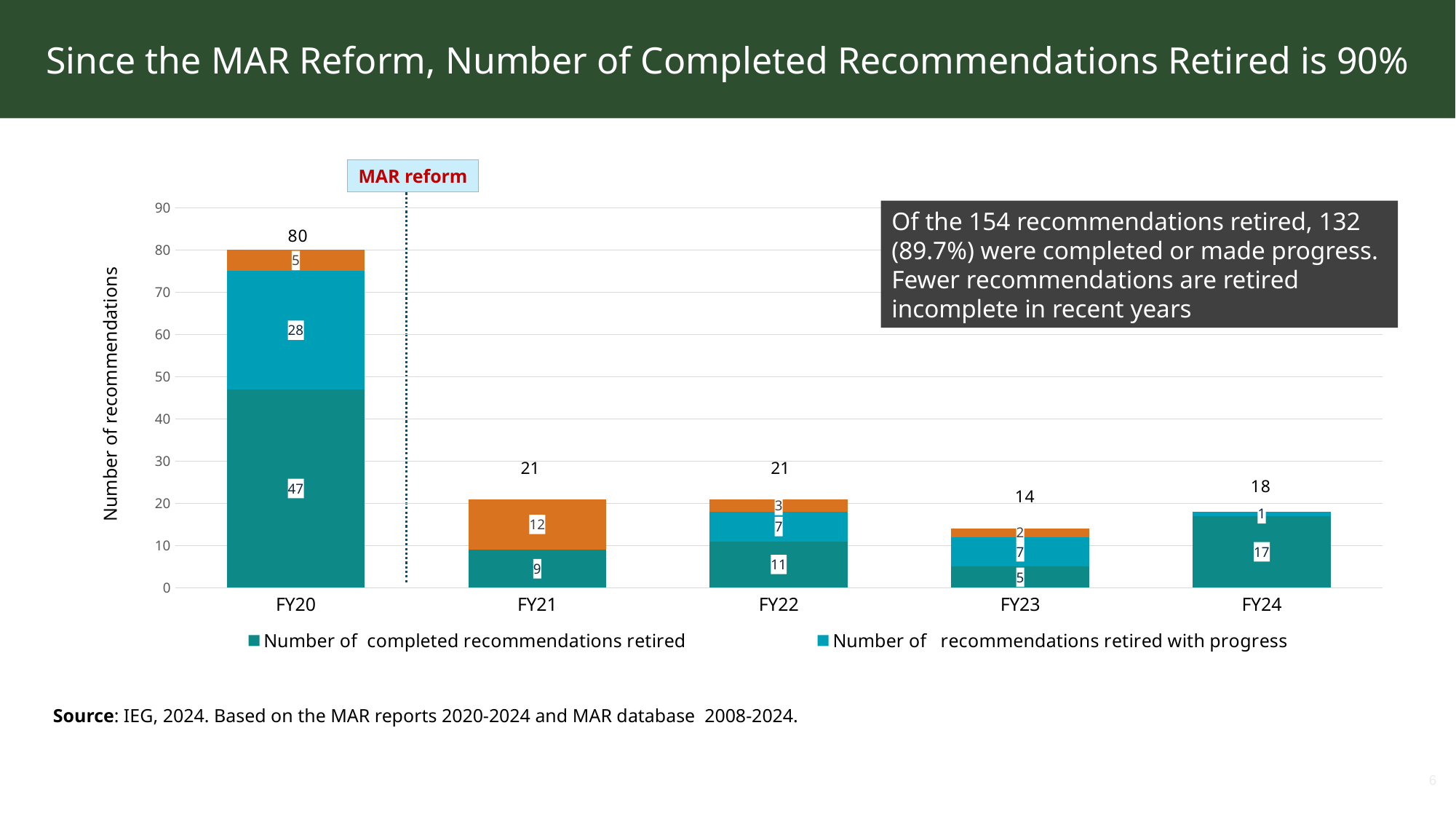
What is the number of completed recommendations retired in FY20? 47 What is the total number of recommendations retired in FY20? 80 How many fiscal years are shown on the x axis? 5 Which fiscal year has the highest total number of recommendations retired? FY20 Which year has more completed recommendations retired, FY22 or FY23? FY22 Which fiscal year has the lowest total number of recommendations retired? FY23 What kind of chart is shown on the slide? Stacked bar chart How many series does the legend list? 2 What is the number of recommendations retired with progress in FY23? 7 What is the difference between the number of completed recommendations retired in FY24 and FY23? 12 What is the title of the y axis? Number of recommendations What is the difference between the total recommendations retired in FY20 and FY21? 59